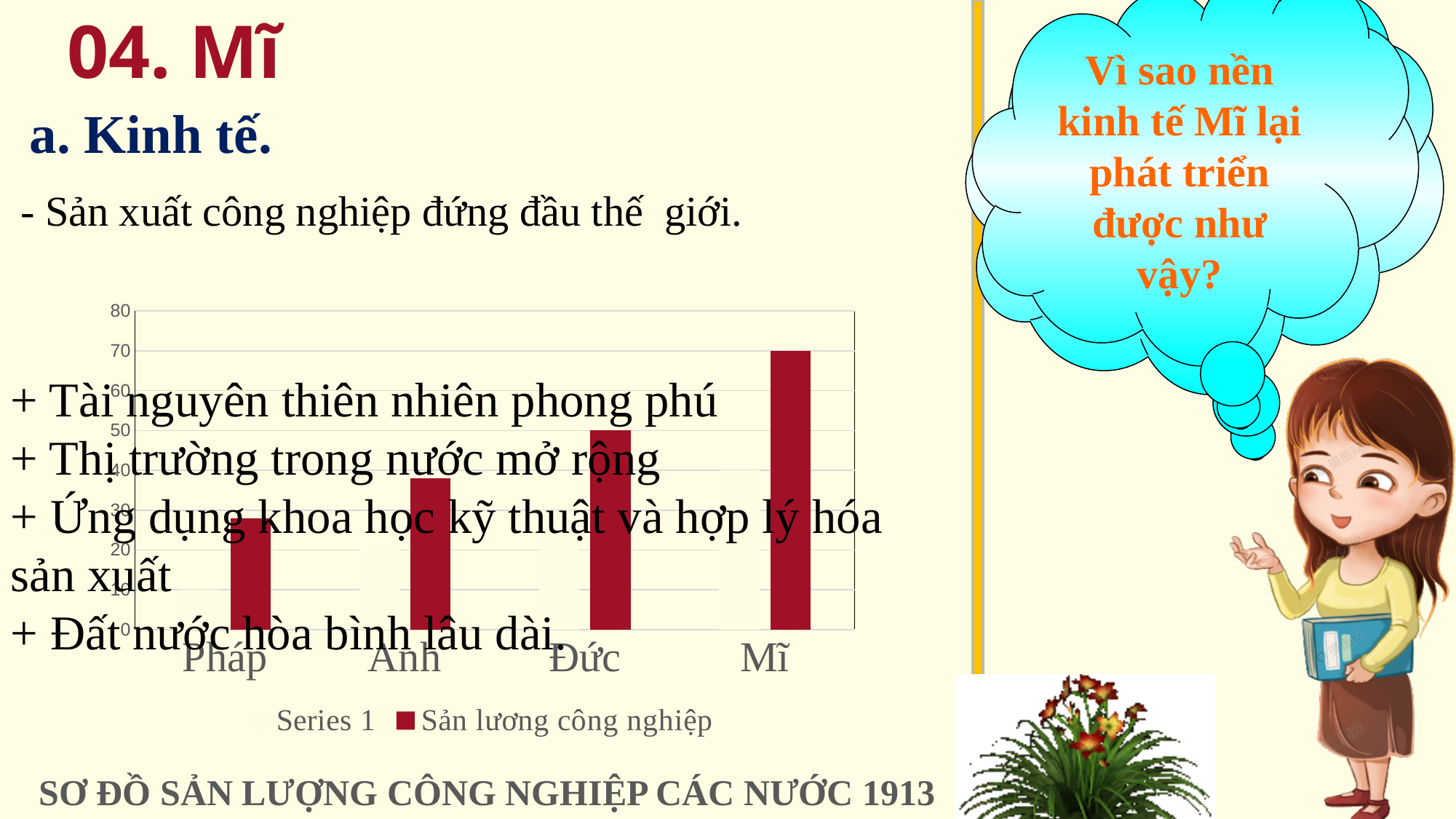
What value does the bar for Đức reach on the axis? 50 Which country has the highest bar in the chart? Mĩ What kind of chart is shown on the slide? bar chart What value does the bar for Mĩ reach on the axis? 70 Which is larger, the value for Anh or the value for Đức? Đức What is the title printed below the chart? SƠ ĐỒ SẢN LƯỢNG CÔNG NGHIỆP CÁC NƯỚC 1913 How many countries are shown on the x axis of the chart? 4 What is the difference between the values for Mĩ and Đức? 20 Do the bar values rise or fall from Pháp to Mĩ along the x axis? rise Is the value for Anh greater or less than 30? greater Which country has the lowest bar in the chart? Pháp